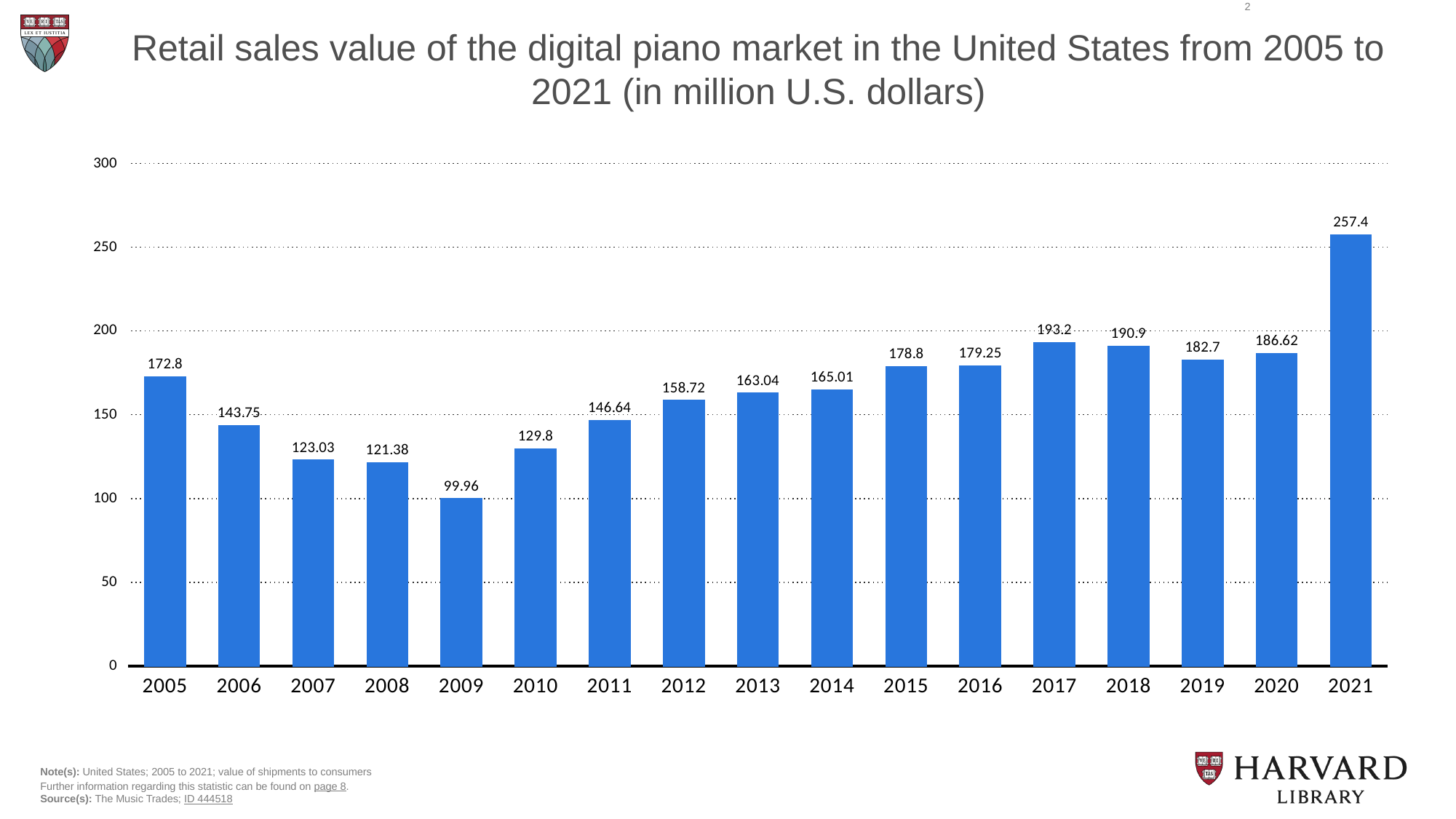
Which year had the highest retail sales value of the digital piano market? 2021 What was the retail sales value of the digital piano market in the United States in 2009? 99.96 What was the retail sales value of the digital piano market in the United States in 2021? 257.4 How many years are shown on the chart? 17 Which year had the lowest retail sales value of the digital piano market? 2009 Is the retail sales value for 2017 greater or less than 150? greater Did the retail sales value rise or fall from 2009 to 2017? Rise What is the difference in retail sales value between 2021 and 2020? 70.78 What is the source of the data shown on the slide? The Music Trades What was the retail sales value of the digital piano market in the United States in 2014? 165.01 What type of chart is shown on the slide? Bar chart Which year had a higher retail sales value, 2005 or 2006? 2005